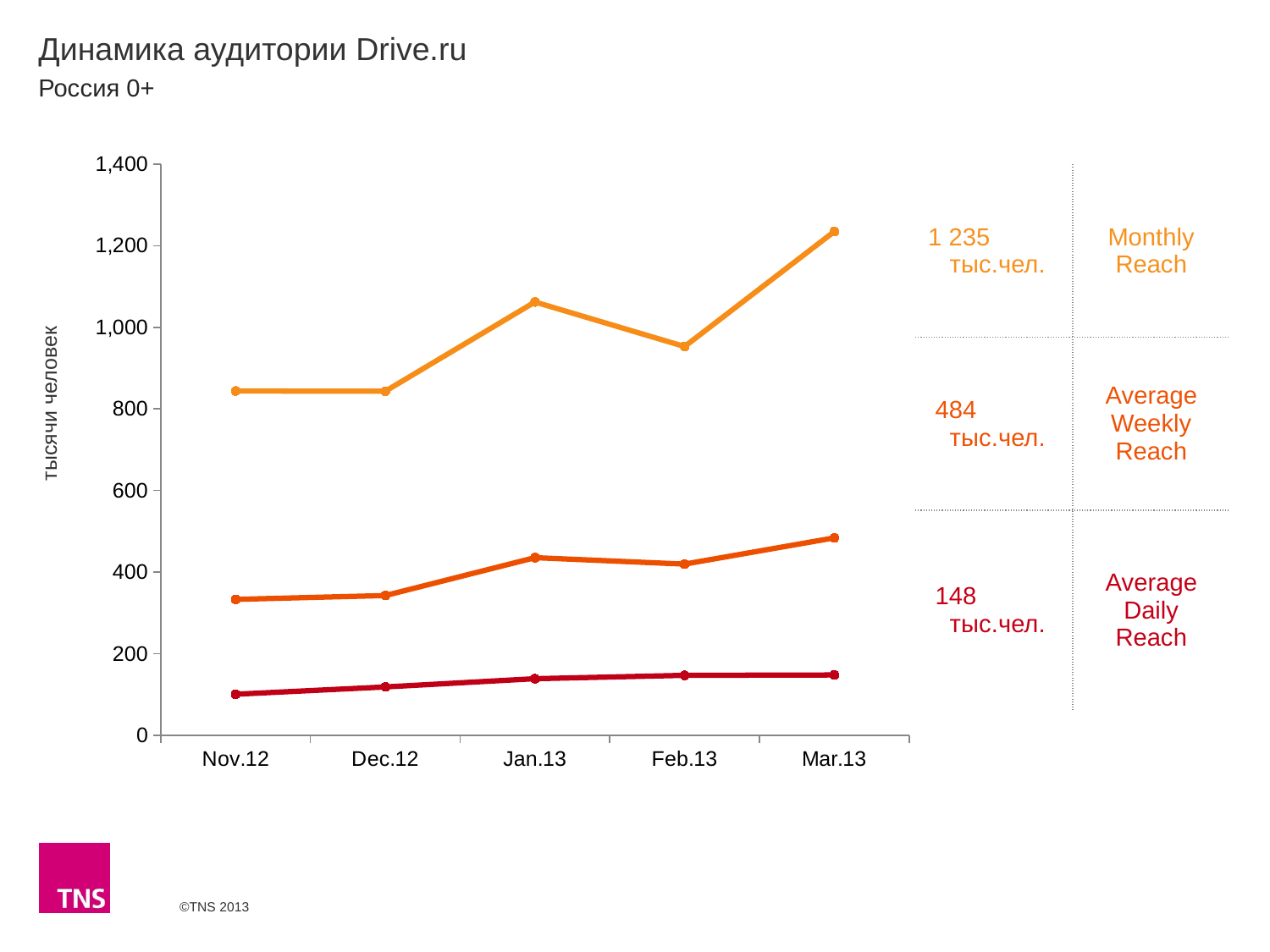
How many time points are plotted along the x axis? 5 At which time point is the Monthly Reach line highest? Mar.13 Is the Average Weekly Reach value for Jan.13 greater or less than 400? greater What is the difference between the printed Monthly Reach (1 235 тыс.чел.) and Average Weekly Reach (484 тыс.чел.) values? 751 тыс.чел. What Average Daily Reach value is printed beside the chart? 148 тыс.чел. Is the Monthly Reach value for Feb.13 greater or less than 1,000? less How many series (lines) are plotted on the chart? 3 What Average Weekly Reach value is printed beside the chart? 484 тыс.чел. What kind of chart is shown on the slide? line chart Does the Average Daily Reach line rise or fall from Nov.12 to Mar.13? rise What Monthly Reach value is printed beside the chart? 1 235 тыс.чел. Which is larger, the Monthly Reach value for Jan.13 or for Feb.13? Jan.13